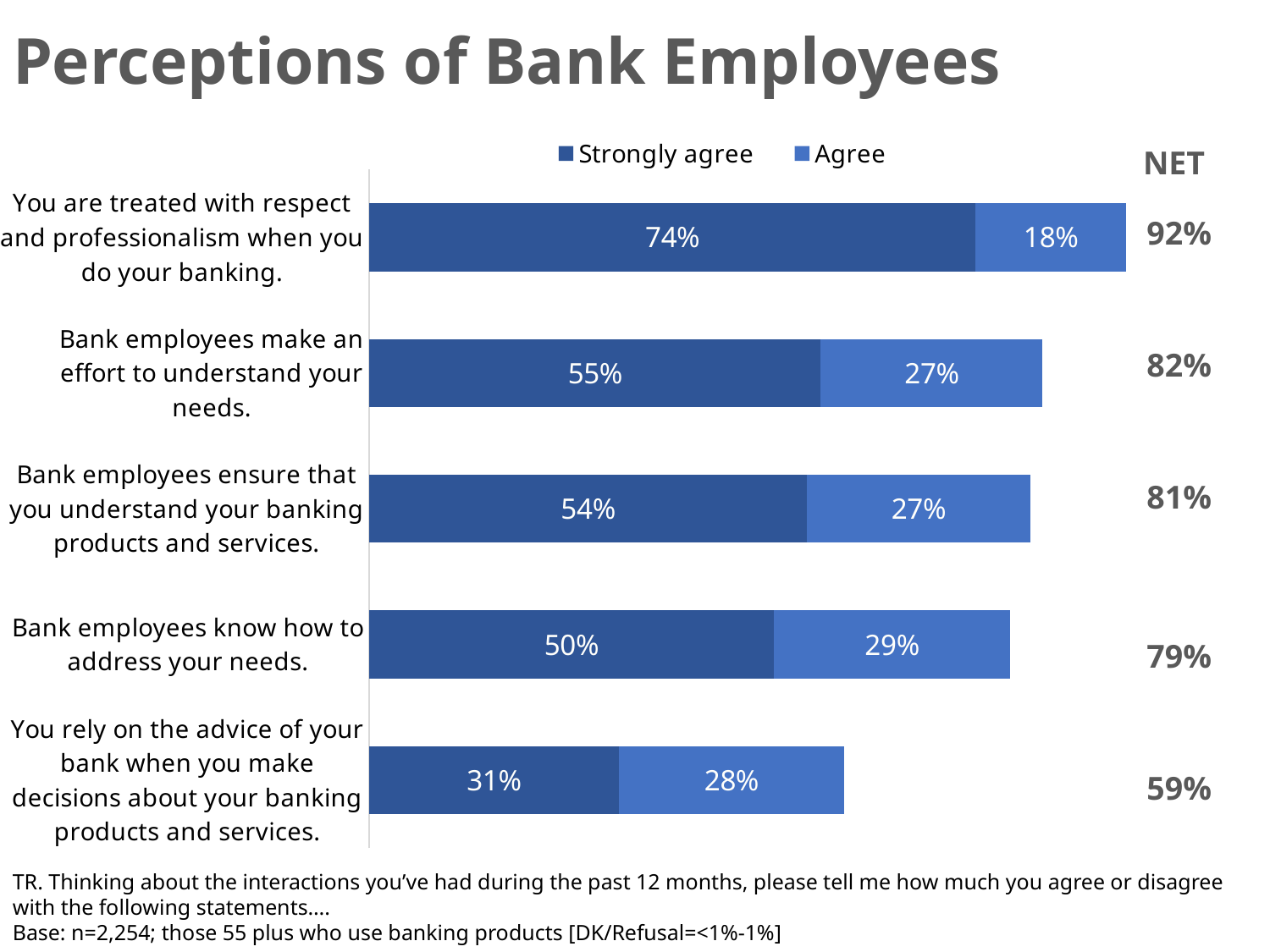
How many statements are shown in the chart? 5 What percentage agree (not strongly) that bank employees know how to address their needs? 29% What is the difference between the 'Strongly agree' percentages for 'Bank employees make an effort to understand your needs' and 'You rely on the advice of your bank when you make decisions about your banking products and services'? 24% What is the total of the stacked bar for 'Bank employees ensure that you understand your banking products and services'? 81% What are the two series named in the legend? Strongly agree and Agree How many series does the legend list? 2 What is the NET value for 'Bank employees make an effort to understand your needs'? 82% Which statement has the highest 'Strongly agree' percentage? You are treated with respect and professionalism when you do your banking. What percentage strongly agree that they are treated with respect and professionalism when they do their banking? 74% Which is larger: the 'Agree' percentage for 'Bank employees know how to address your needs' or the 'Agree' percentage for 'You are treated with respect and professionalism when you do your banking'? Bank employees know how to address your needs. Which statement has the lowest NET value? You rely on the advice of your bank when you make decisions about your banking products and services. What kind of chart is shown on the slide? Stacked bar chart